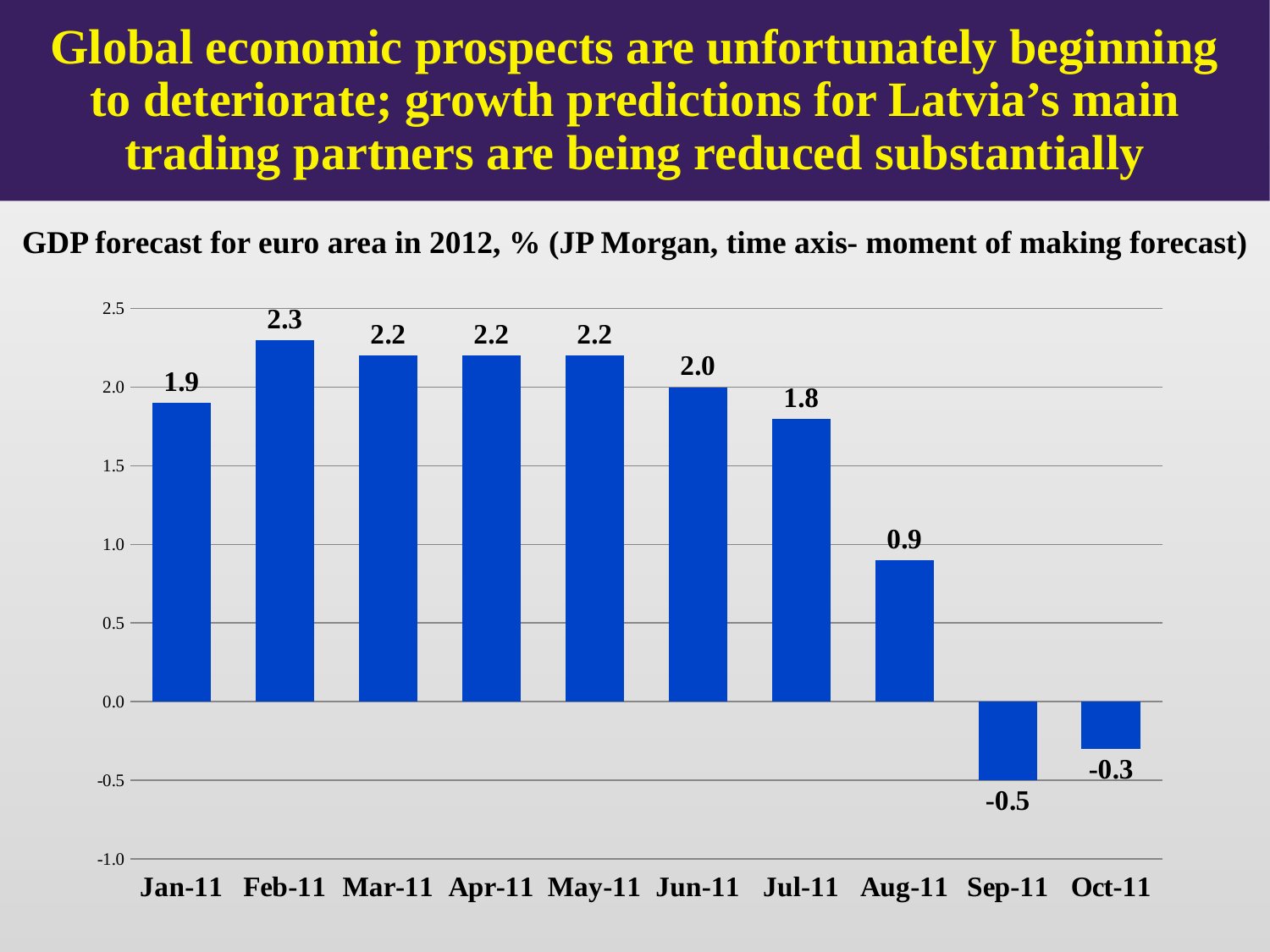
What is the GDP forecast value for Aug-11? 0.9 What is the GDP forecast value for Jan-11? 1.9 What is the GDP forecast value for Sep-11? -0.5 What kind of chart is shown on the slide? bar chart Do the forecast values generally rise or fall from Feb-11 to Oct-11? fall Is the value for Aug-11 greater or less than 1.0? less What is the difference between the Feb-11 and Oct-11 forecast values? 2.6 Which is larger, the forecast for Jun-11 or Jul-11? Jun-11 Which month has the lowest GDP forecast value? Sep-11 Which institution's forecasts are shown in the chart, according to the chart title? JP Morgan How many months are shown on the x axis? 10 Which month has the highest GDP forecast value? Feb-11